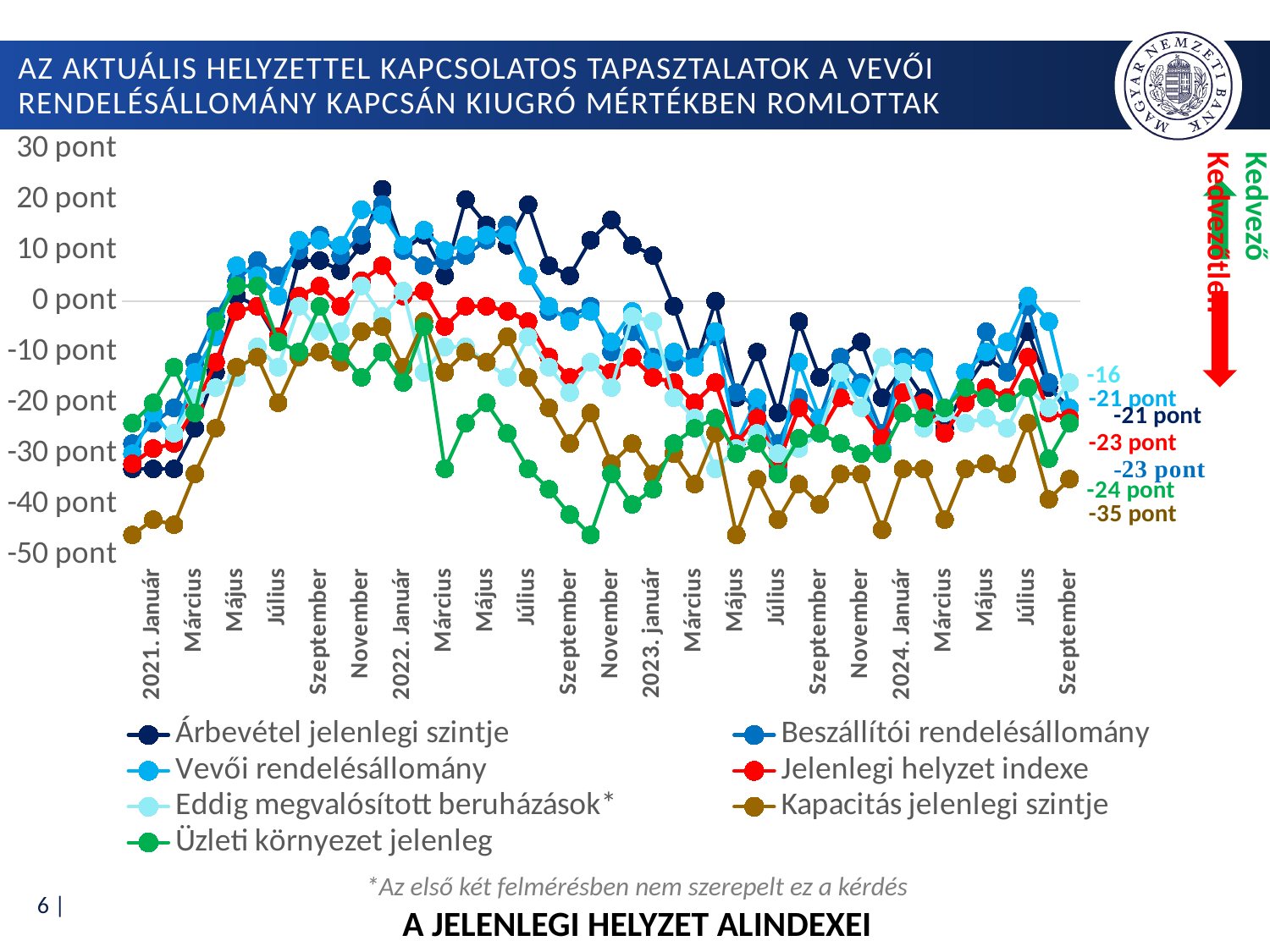
Which series has the lowest labelled value at the end of the chart? Kapacitás jelenlegi szintje How many series does the legend list? 7 What kind of chart is shown on the slide? line chart Is the value for Kapacitás jelenlegi szintje in 2021. Január greater or less than -40 pont? less What is the title printed below the chart? A JELENLEGI HELYZET ALINDEXEI What is the latest labelled value for the Kapacitás jelenlegi szintje series? -35 pont What is the latest labelled value for the Eddig megvalósított beruházások* series? -16 What is the latest labelled value for the Jelenlegi helyzet indexe series? -23 pont Which series has the highest labelled value at the end of the chart? Eddig megvalósított beruházások* What is the difference between the latest labelled values of Üzleti környezet jelenleg (-24 pont) and Kapacitás jelenlegi szintje (-35 pont)? 11 pont What is the latest labelled value for the Üzleti környezet jelenleg series? -24 pont